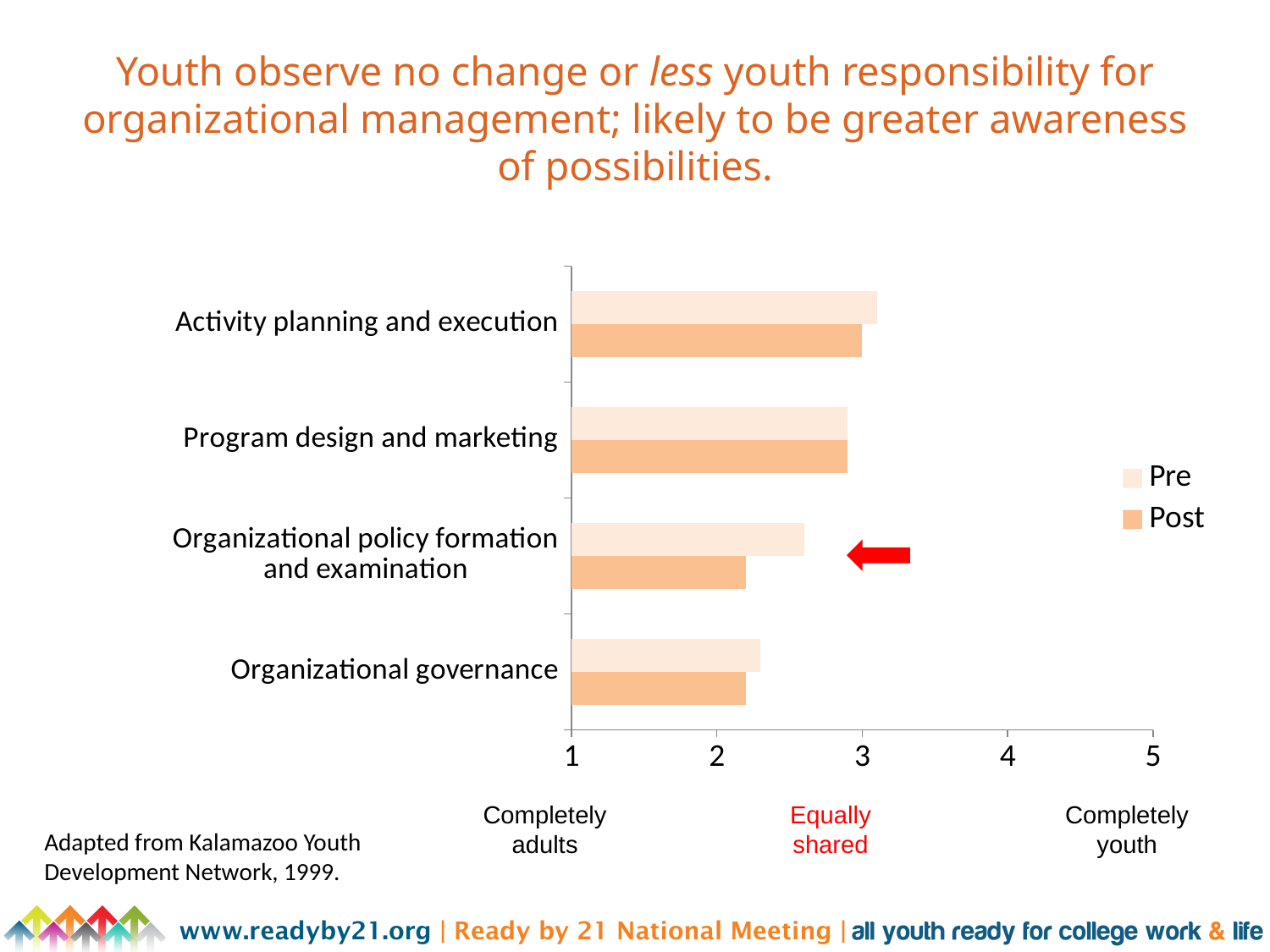
What are the two series named in the legend? Pre and Post How many categories are plotted on the chart? 4 For Organizational policy formation and examination, which is larger, the Pre value or the Post value? Pre Which category has the lowest Pre value? Organizational governance Which category has the highest Pre value? Activity planning and execution Is the Pre value for Activity planning and execution greater or less than 2? greater Which category does the red arrow on the chart point to? Organizational policy formation and examination Is the Post value for Organizational policy formation and examination greater or less than 3? less What kind of chart is shown on the slide? bar chart How many series does the chart's legend list? 2 Which has the larger Pre value, Activity planning and execution or Organizational governance? Activity planning and execution Is the Pre value for Organizational governance greater or less than 3? less